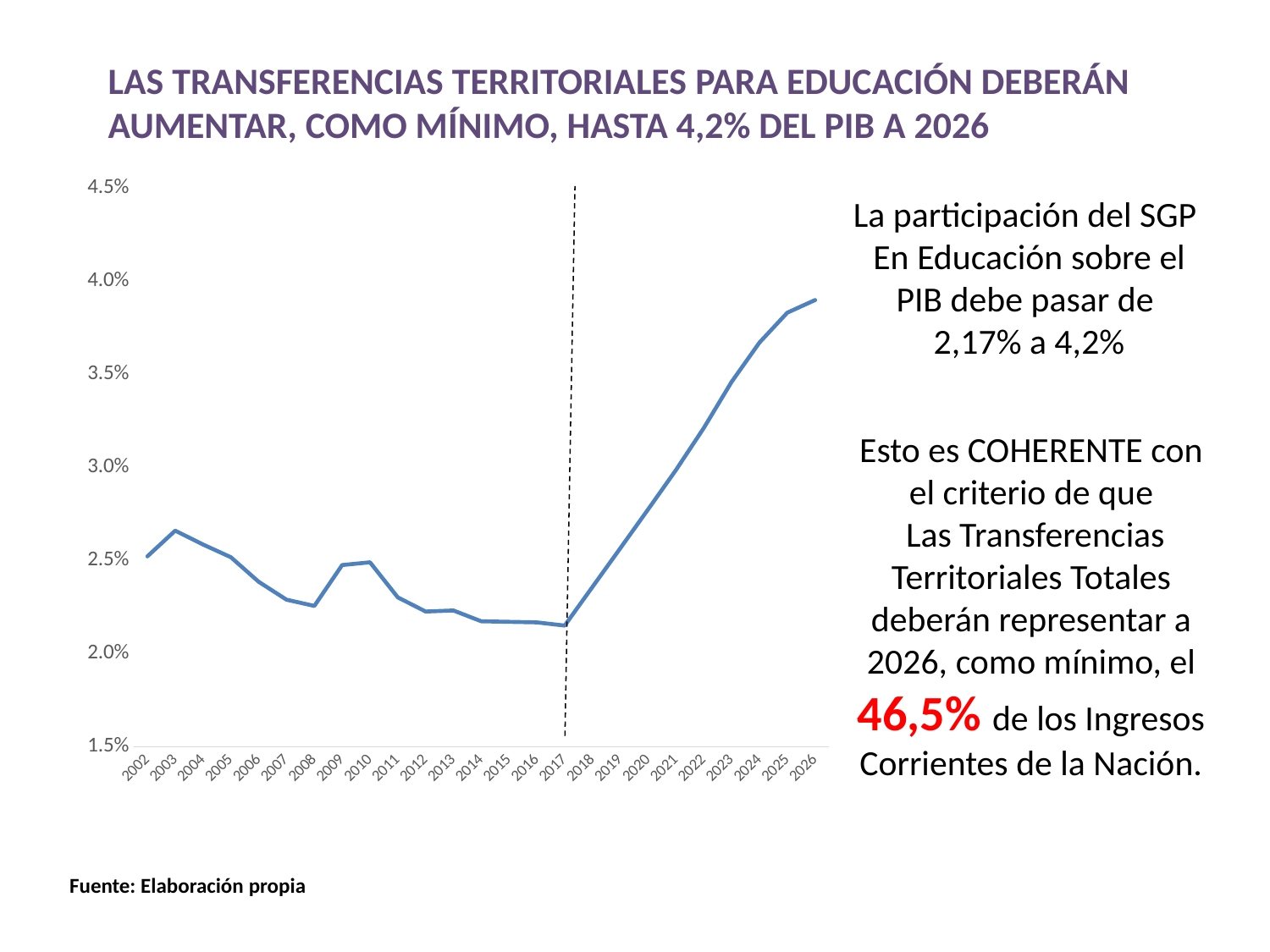
What kind of chart is shown on the slide? line chart What is the first year shown on the x axis? 2002 Is the value for 2003 greater or less than 2.5%? greater Is the value for 2026 greater or less than 3.5%? greater At which year is the dashed vertical line placed on the chart? 2017 Is the value for 2022 greater or less than 3.0%? greater Which is larger, the value for 2003 or the value for 2008? 2003 How many years are plotted along the x axis of the chart? 25 Do the values rise or fall from 2017 to 2026? rise Which year has the highest value on the chart? 2026